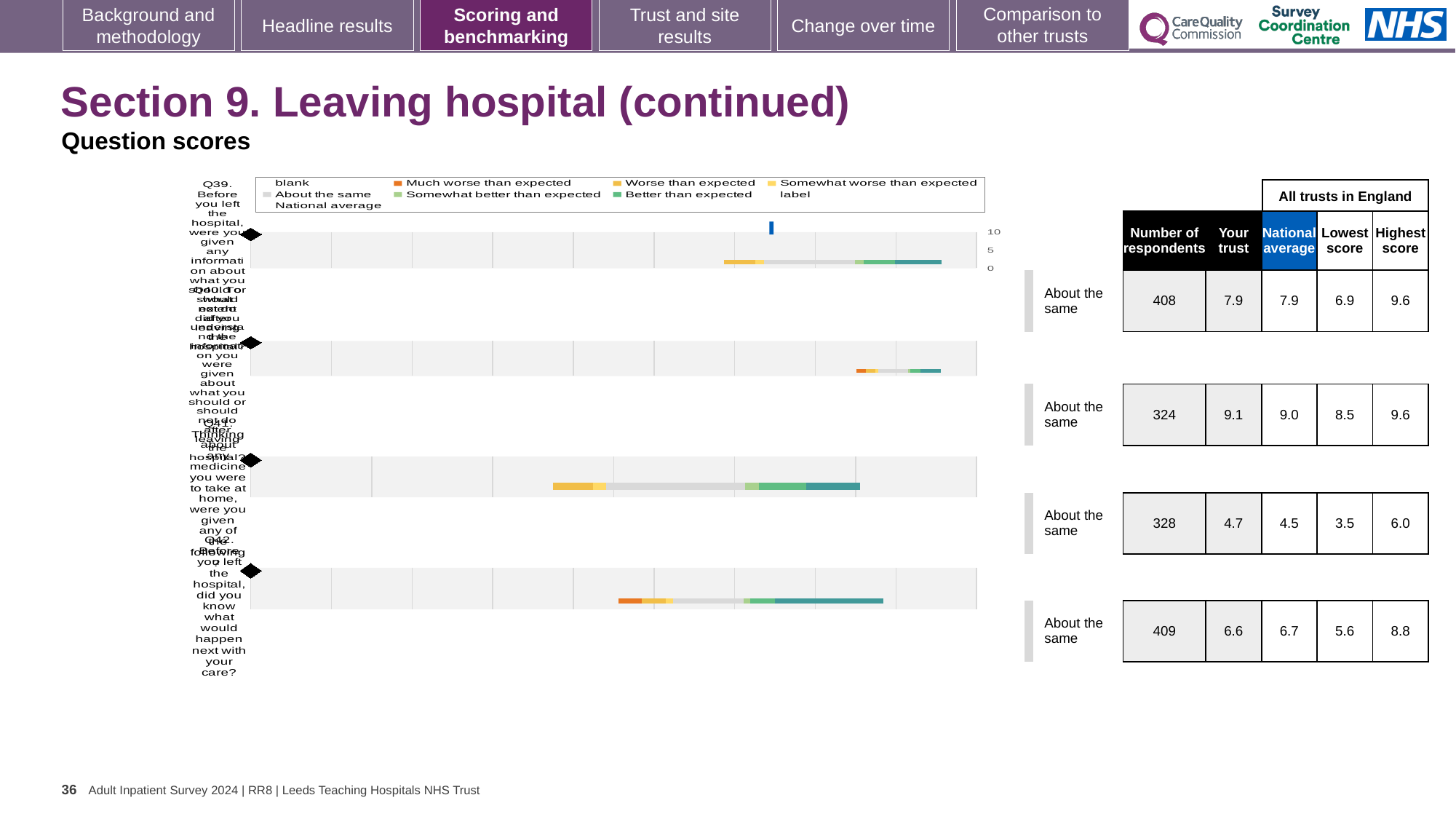
In the table to the right of the chart, which row has the highest 'Your trust' score? the second row (9.1) What kind of chart is shown on the left of the slide? bar chart In the table to the right of the chart, what is the highest score in the third row? 6.0 In the table to the right of the chart, what is the number of respondents in the first row? 408 In the table to the right of the chart, is the 'Your trust' score or the national average larger in the third row? Your trust In the table to the right of the chart, what is the 'Your trust' score in the first row? 7.9 Which question label appears at the top of the chart on the left? Q39 In the table to the right of the chart, which row has the lowest 'Your trust' score? the third row (4.7) In the table to the right of the chart, what is the difference between the 'Your trust' score and the national average in the third row? 0.2 What benchmark label is shown beside each bar of the chart? About the same In the table to the right of the chart, what is the lowest score in the fourth row? 5.6 How many question rows (bars) does the chart on the left show? 4